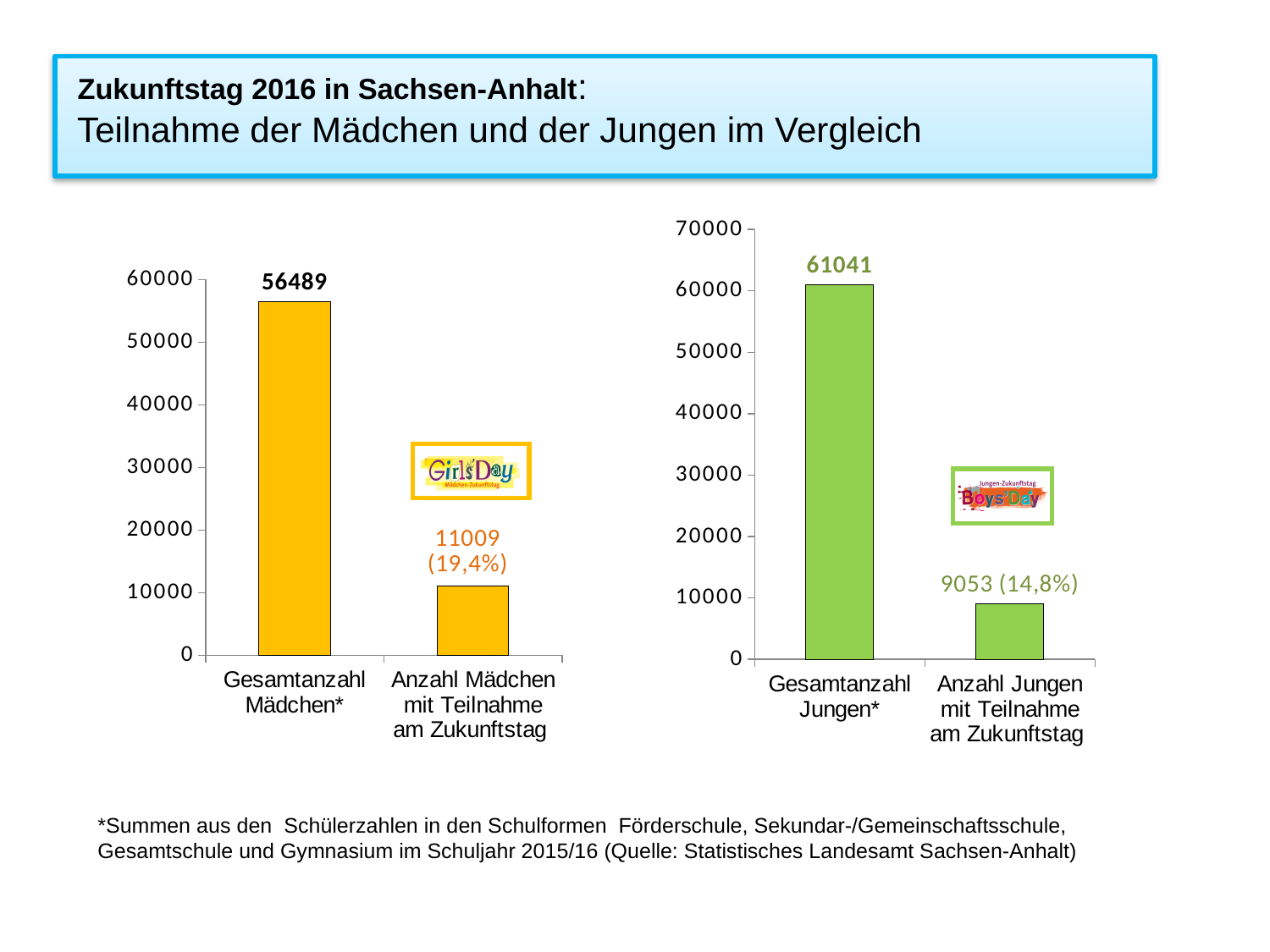
How many categories does the right chart show? 2 In the left chart, what is the value for Gesamtanzahl Mädchen*? 56489 In the left chart, what is the value for Anzahl Mädchen mit Teilnahme am Zukunftstag? 11009 In the left chart, what percentage is shown next to the value for Anzahl Mädchen mit Teilnahme am Zukunftstag? 19,4% In the right chart, what percentage is shown next to the value for Anzahl Jungen mit Teilnahme am Zukunftstag? 14,8% Which is larger: Gesamtanzahl Mädchen* in the left chart or Gesamtanzahl Jungen* in the right chart? Gesamtanzahl Jungen* In the right chart, what is the difference between Gesamtanzahl Jungen* and Anzahl Jungen mit Teilnahme am Zukunftstag? 51988 In the left chart, what is the difference between Gesamtanzahl Mädchen* and Anzahl Mädchen mit Teilnahme am Zukunftstag? 45480 What kind of chart is the left chart? bar chart In the right chart, what is the value for Anzahl Jungen mit Teilnahme am Zukunftstag? 9053 In the right chart, what is the value for Gesamtanzahl Jungen*? 61041 In the right chart, is the value for Anzahl Jungen mit Teilnahme am Zukunftstag greater or less than 10000? less